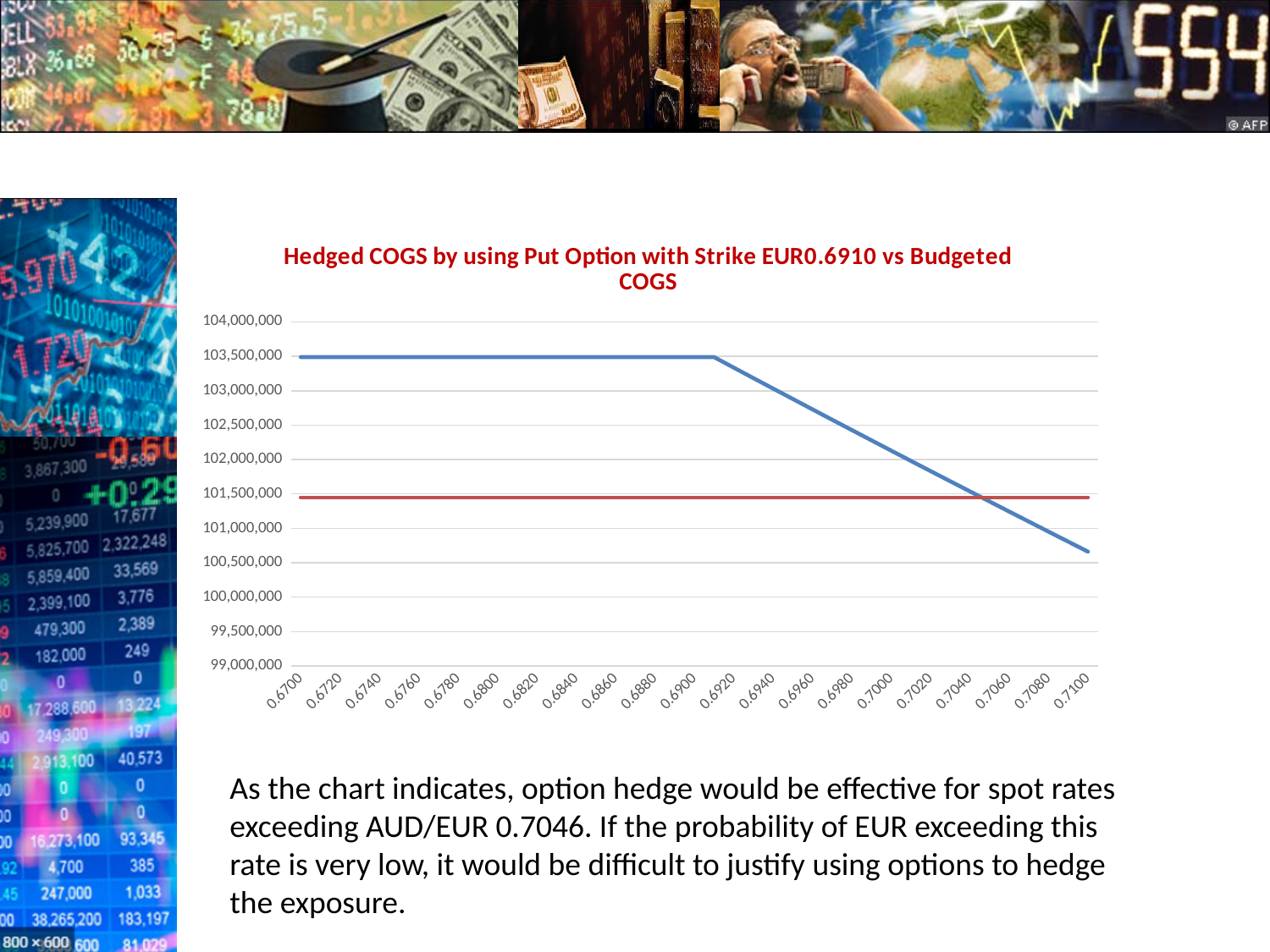
Is the value of the blue line at 0.7100 greater or less than 101,000,000? less Is the value of the red line greater or less than 102,000,000? less What is the title of the chart? Hedged COGS by using Put Option with Strike EUR0.6910 vs Budgeted COGS Does the blue line rise, fall or stay flat between 0.6700 and 0.6900? stay flat What kind of chart is shown on the slide? line chart At a spot rate of 0.7100, which line is higher, the blue line or the red line? the red line Is the value of the red line greater or less than 101,000,000? greater Does the blue line rise, fall or stay flat between 0.6900 and 0.7100? fall What is the highest value shown on the y axis of the chart? 104,000,000 At a spot rate of 0.6700, which line is higher, the blue line or the red line? the blue line How many spot-rate points are labelled along the x axis of the chart? 21